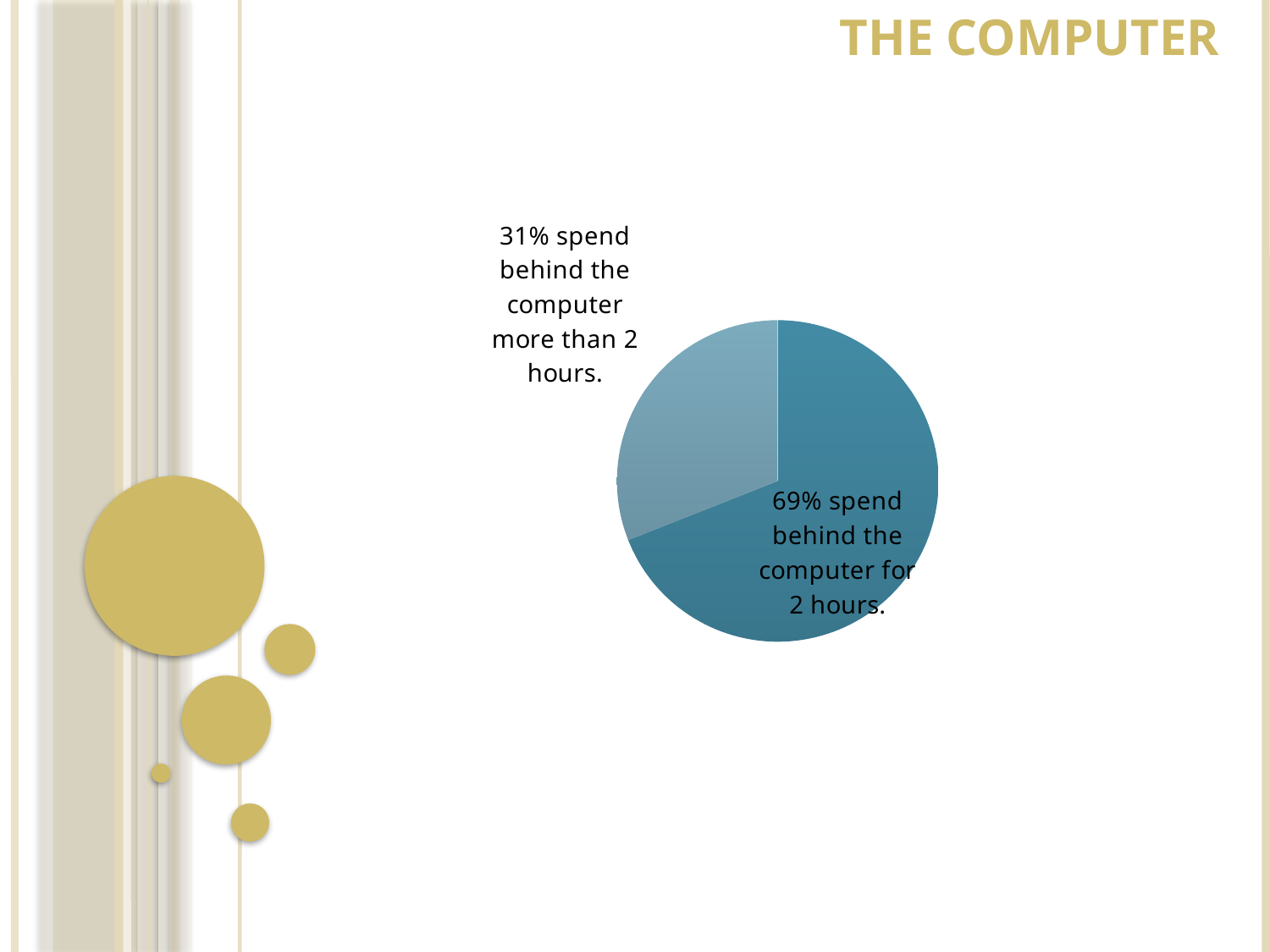
What is the difference in percentage points between those who spend 2 hours and those who spend more than 2 hours behind the computer? 38 Which slice of the pie chart is shown in the lighter blue colour? 31% spend behind the computer more than 2 hours. What percentage spend behind the computer more than 2 hours? 31% What percentage spend behind the computer for 2 hours? 69% How many slices does the pie chart have? 2 Which slice is the largest in the pie chart? 69% spend behind the computer for 2 hours. What is the title of the slide containing the pie chart? THE COMPUTER What kind of chart is shown on the slide? pie chart What is the total of the two slices in the pie chart? 100% Which is larger: the share spending 2 hours behind the computer or the share spending more than 2 hours? 2 hours Which slice is the smallest in the pie chart? 31% spend behind the computer more than 2 hours.